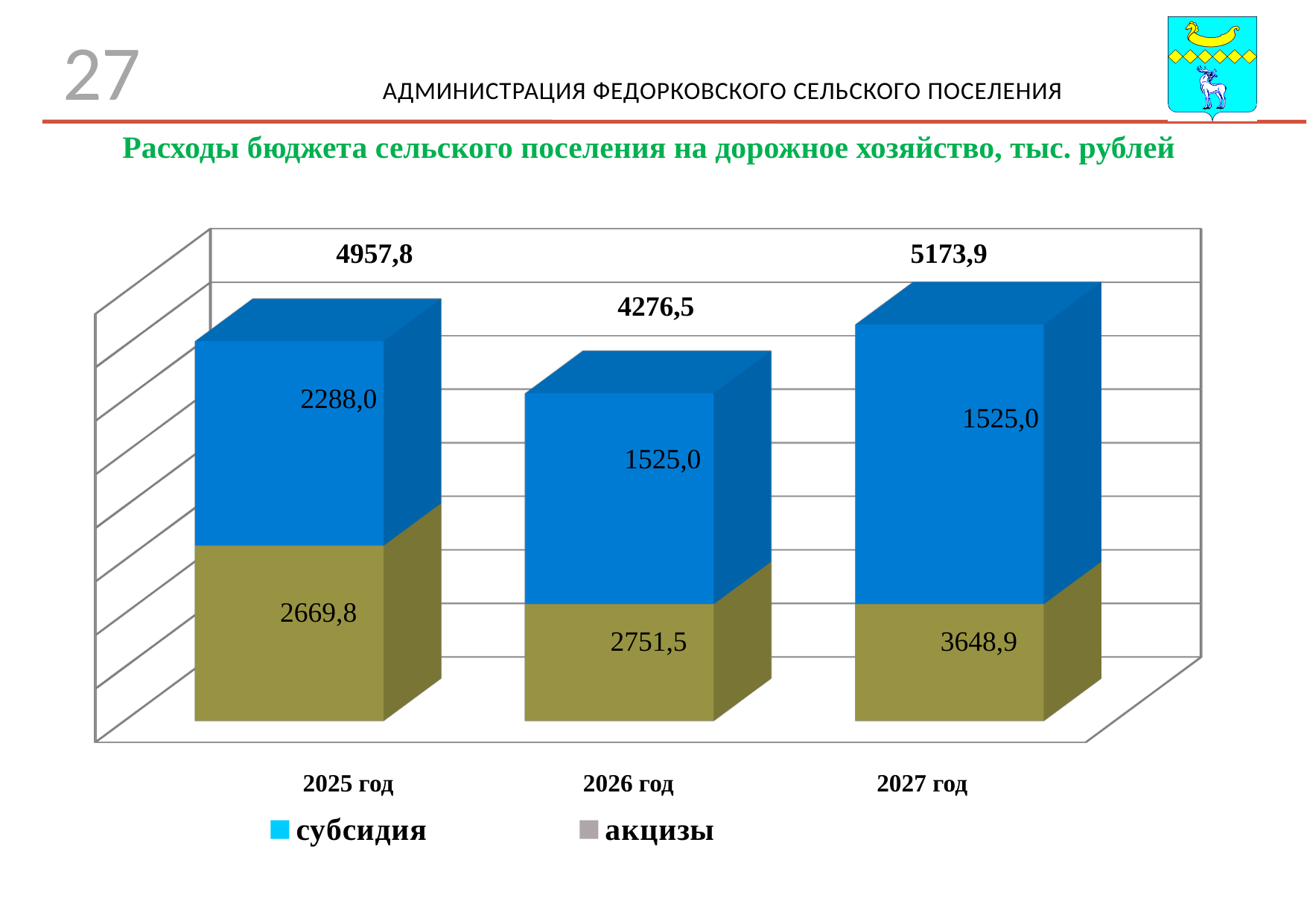
What is the total value of the bar for 2026 год? 4276,5 What is the difference between the акцизы values for 2027 год and 2025 год? 979,1 What is the value of акцизы for 2027 год? 3648,9 How many years (categories) are shown on the x axis? 3 Which year has the lowest total expenditure? 2026 год Which is larger in 2025 год: субсидия or акцизы? акцизы How many series does the legend list? 2 What is the value of субсидия for 2025 год? 2288,0 What is the total value of the bar for 2025 год? 4957,8 Which year has the highest total expenditure? 2027 год What is the value of акцизы for 2026 год? 2751,5 What kind of chart is shown on the slide? stacked bar chart